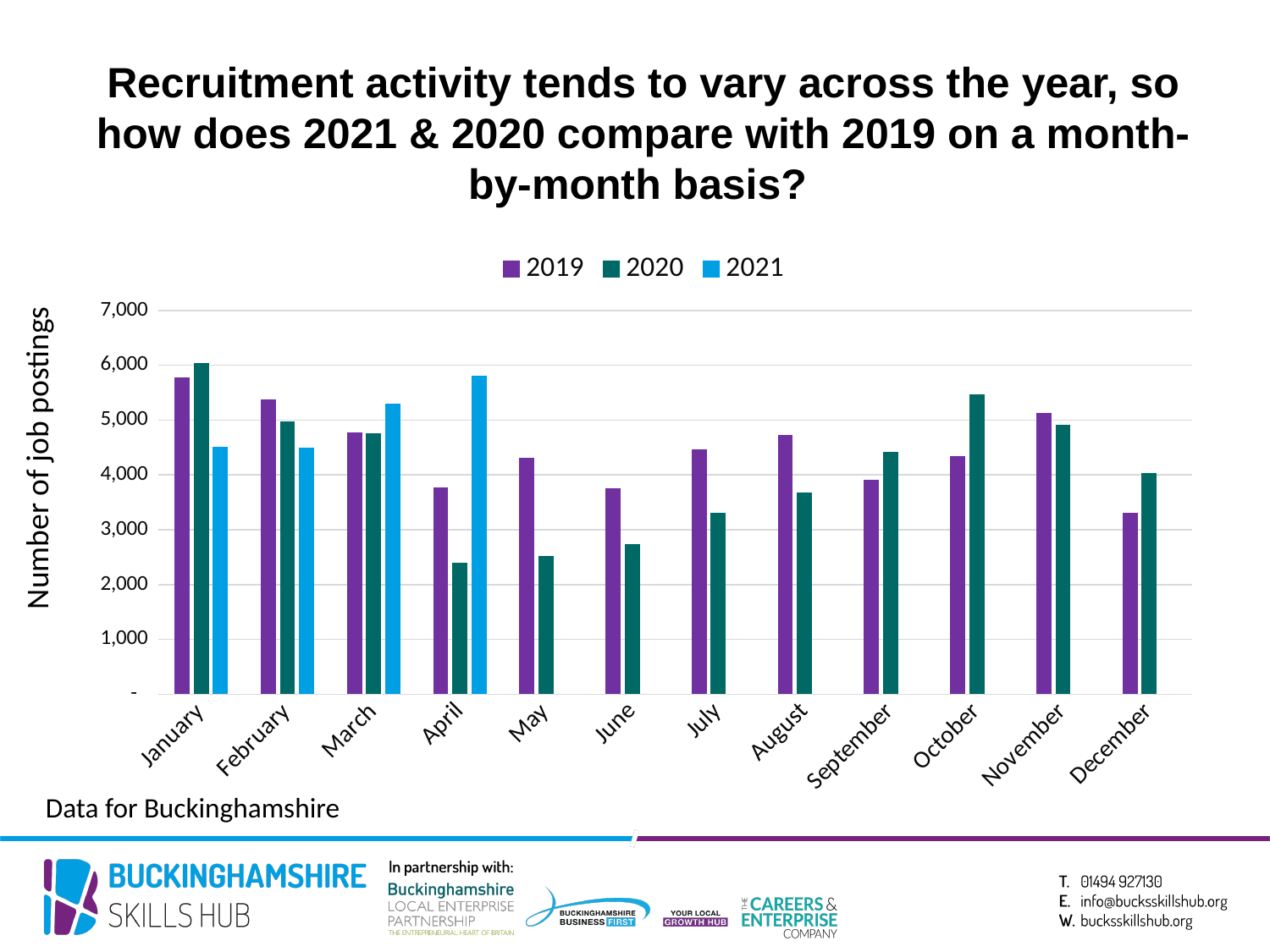
How many months are shown on the x axis? 12 What kind of chart is shown on the slide? Bar chart For how many months is a 2021 bar plotted? 4 What is the label on the y axis? Number of job postings Is the 2020 value for April greater or less than 3,000? less Is the 2020 value for October greater or less than 5,000? greater Which month has the lowest number of job postings for 2019? December Is the 2021 value for April greater or less than 5,000? greater In January, which year has more job postings, 2019 or 2020? 2020 Which month has the highest number of job postings for 2020? January How many series does the legend list? 3 Which month has the highest number of job postings for 2019? January